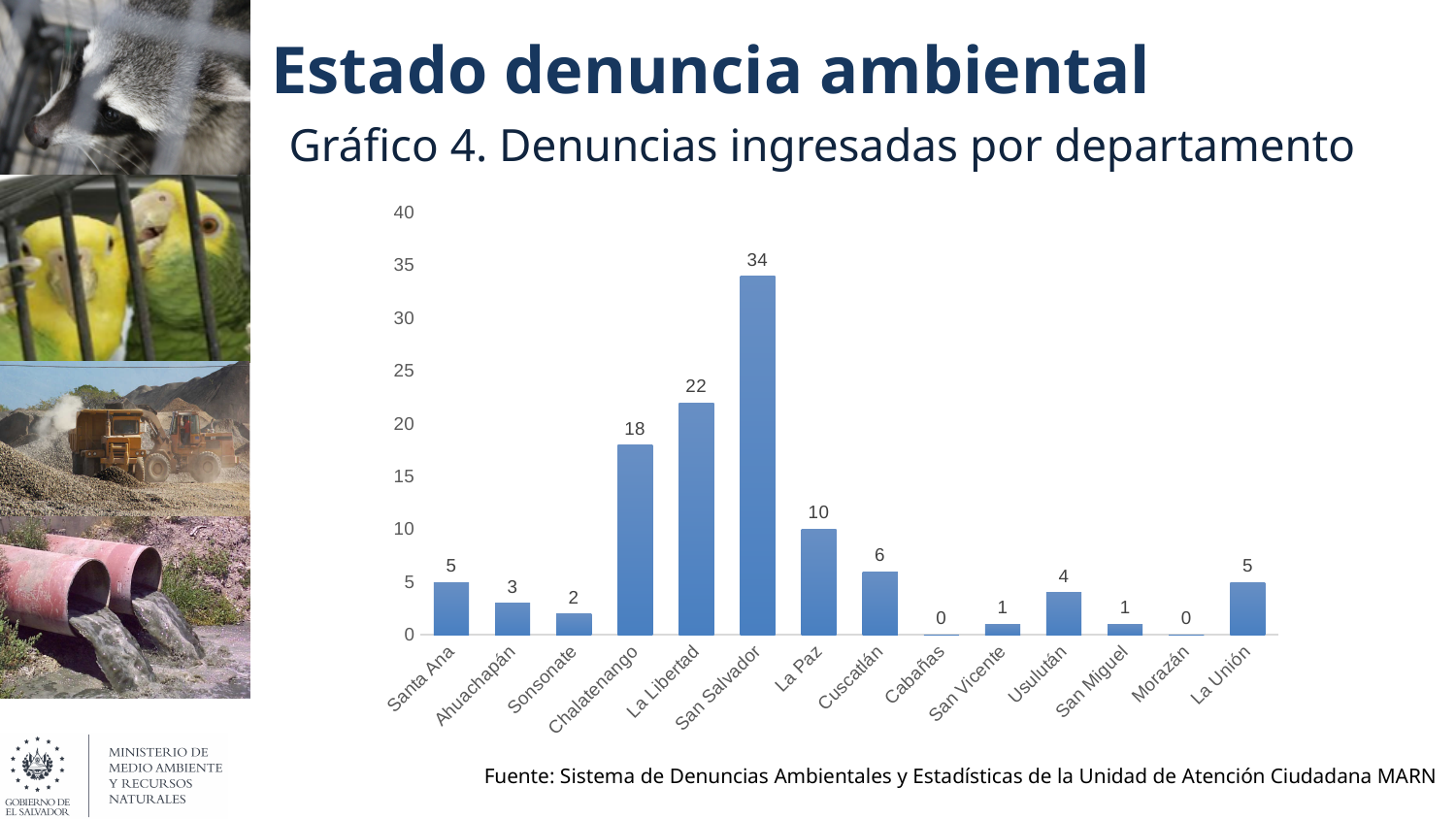
What is the title of the chart? Gráfico 4. Denuncias ingresadas por departamento Which department has the highest number of complaints? San Salvador What is the difference between the values for Chalatenango and Cuscatlán? 12 What is the value for Chalatenango? 18 What type of chart is shown on the slide? bar chart How many departments are shown on the x axis? 14 What is the value for La Paz? 10 What is the difference between the values for San Salvador and La Libertad? 12 Is the value for La Libertad greater or less than 20? greater Which has a larger value, La Paz or Cuscatlán? La Paz How many complaints were entered for San Salvador? 34 What is the value for Usulután? 4